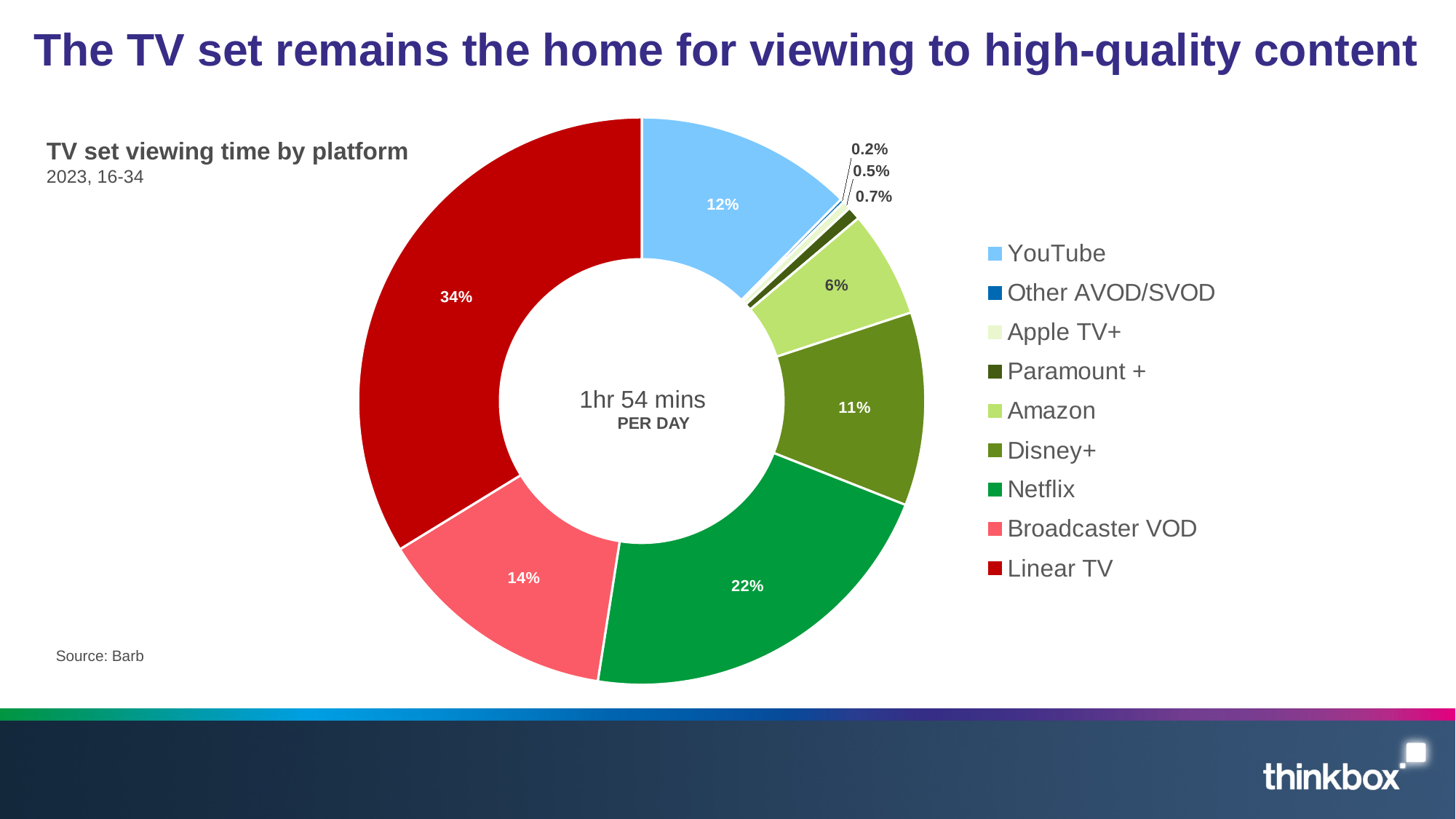
What share of TV set viewing time does Disney+ account for? 11% What share of TV set viewing time does Netflix account for? 22% How many platforms are listed in the chart legend? 9 Which platform has the largest share of TV set viewing time? Linear TV What share of TV set viewing time does YouTube account for? 12% Which has a larger share of TV set viewing time, Broadcaster VOD or YouTube? Broadcaster VOD What is the difference in share between Linear TV and Netflix? 12 percentage points What total daily viewing time is shown in the centre of the donut chart? 1hr 54 mins per day What kind of chart is shown on the slide? Pie chart (donut) What share of TV set viewing time does Broadcaster VOD account for? 14% What share of TV set viewing time does Linear TV account for? 34% Which platform has the smallest share of TV set viewing time? Other AVOD/SVOD